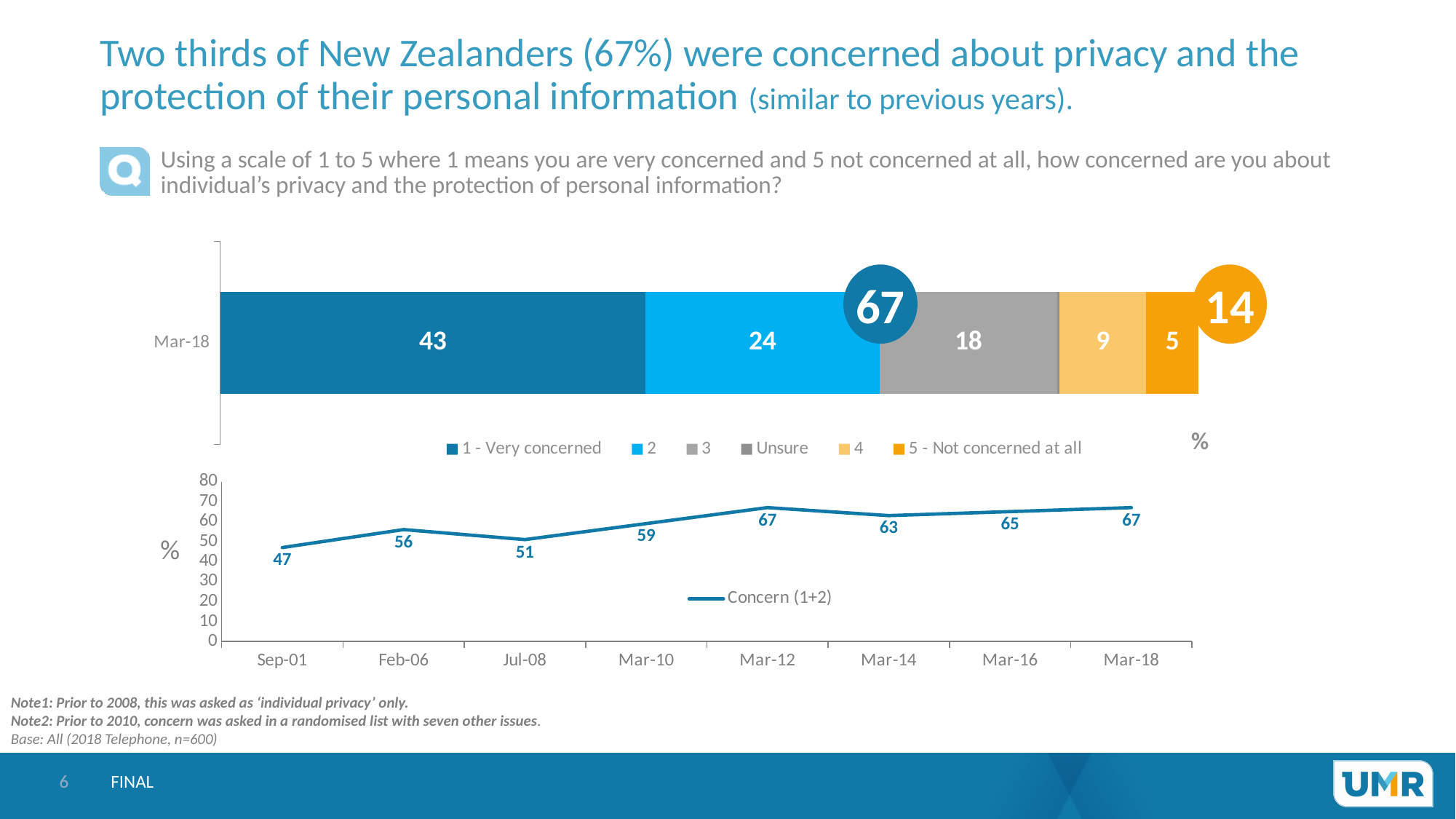
In the bottom line chart, is the Concern (1+2) value for Feb-06 larger or smaller than for Jul-08? larger In the top stacked bar chart, which segment is the largest? 1 - Very concerned In the bottom line chart, what is the Concern (1+2) value for Mar-14? 63 In the top stacked bar chart, what is the difference between the '1 - Very concerned' and '2' segments? 19 In the bottom line chart, which time point has the lowest Concern (1+2) value? Sep-01 In the top stacked bar chart, how many entries does the legend list? 6 In the top stacked bar chart, what is the value for '1 - Very concerned' in Mar-18? 43 What kind of chart is the bottom chart on the slide? line chart In the top stacked bar chart, what is the value for the '3' segment in Mar-18? 18 In the bottom line chart, what is the Concern (1+2) value for Sep-01? 47 In the top stacked bar chart, what is the value for '5 - Not concerned at all' in Mar-18? 5 In the bottom line chart, how many time points are plotted on the x axis? 8